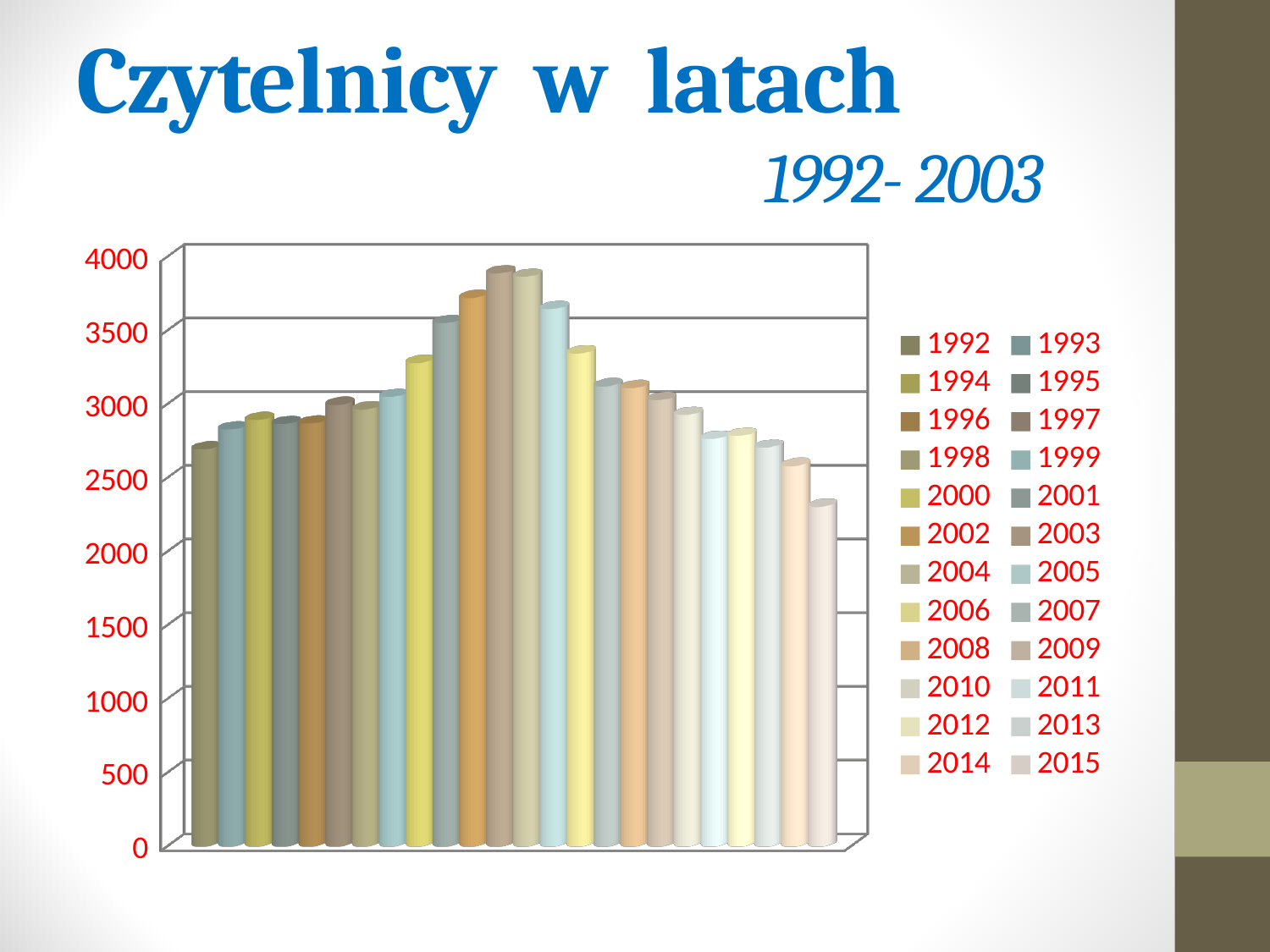
Is the value for 2003 greater or less than 3500? greater Which is larger, the value for 2003 or the value for 1992? 2003 What kind of chart is shown on the slide? bar chart Is the value for 1992 greater or less than 2500? greater Is the value for 2013 greater or less than 3000? less Do the values rise or fall from 2004 to 2015? fall How many bars are plotted in the chart? 24 Which is larger, the value for 2000 or the value for 2015? 2000 How many entries does the chart's legend list? 24 Which year has the lowest bar in the chart? 2015 What is the title of the slide containing the chart? Czytelnicy w latach 1992-2003